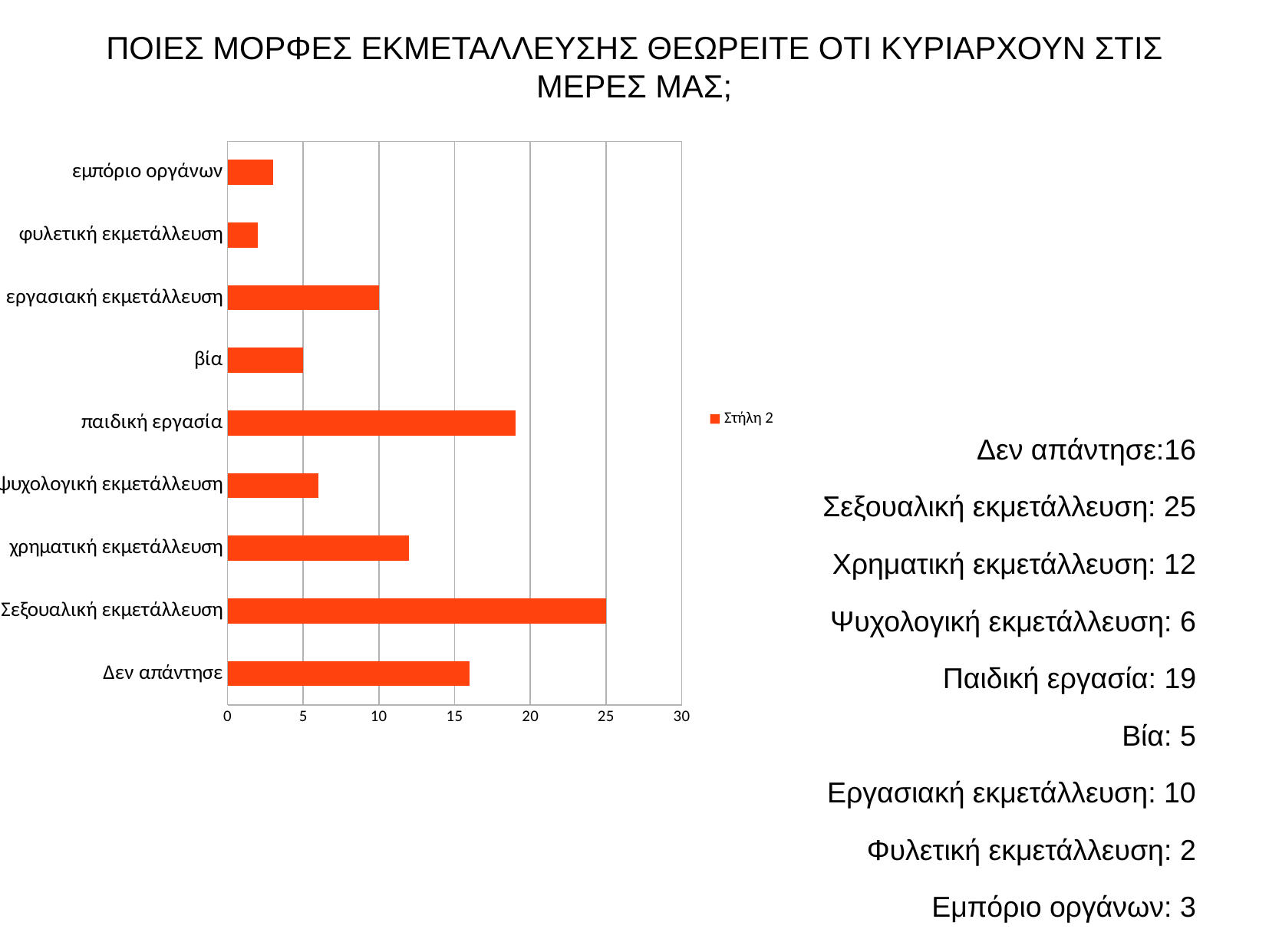
What is the difference between the values for Σεξουαλική εκμετάλλευση and Δεν απάντησε? 9 What is the value for Σεξουαλική εκμετάλλευση? 25 Which category has the lowest value? φυλετική εκμετάλλευση How many categories are plotted in the chart? 9 What is the value for παιδική εργασία? 19 What is the legend entry for the series in the chart? Στήλη 2 Which is larger, the value for χρηματική εκμετάλλευση or the value for εργασιακή εκμετάλλευση? χρηματική εκμετάλλευση What is the value for φυλετική εκμετάλλευση? 2 Which category has the highest value? Σεξουαλική εκμετάλλευση How many series does the legend list? 1 What type of chart is shown on the slide? bar chart Is the value for ψυχολογική εκμετάλλευση greater or less than 10? less